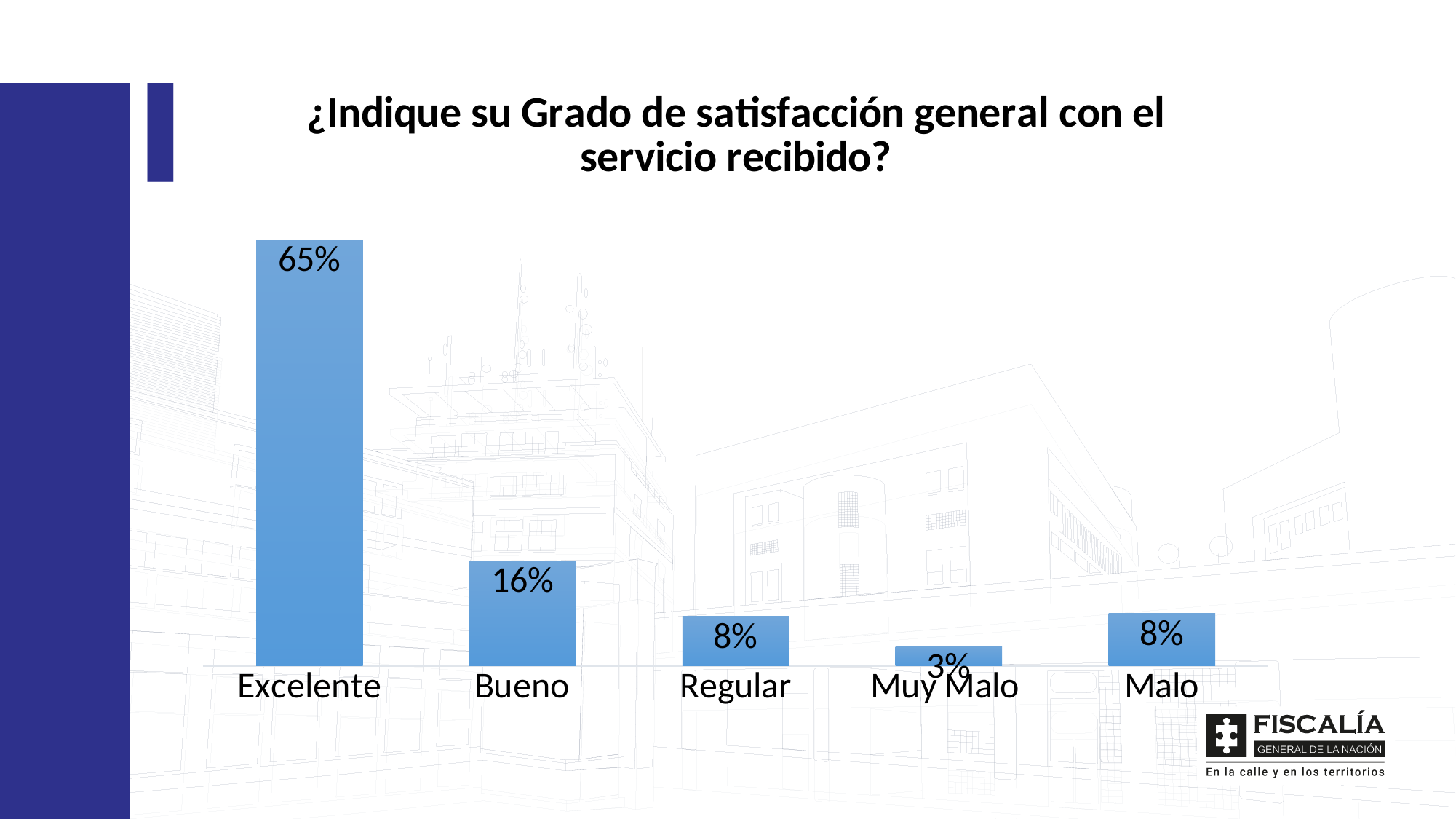
What kind of chart is shown on the slide? Bar chart How many categories are shown in the chart? 5 What is the title of the chart? ¿Indique su Grado de satisfacción general con el servicio recibido? What is the difference between the values for Excelente and Bueno? 49% What is the value for Bueno? 16% Which category has the lowest value? Muy Malo What is the value for Malo? 8% What is the difference between the values for Regular and Muy Malo? 5% Which is larger, the value for Bueno or the value for Malo? Bueno What is the value for Excelente? 65% What is the value for Muy Malo? 3% Which category has the highest value? Excelente